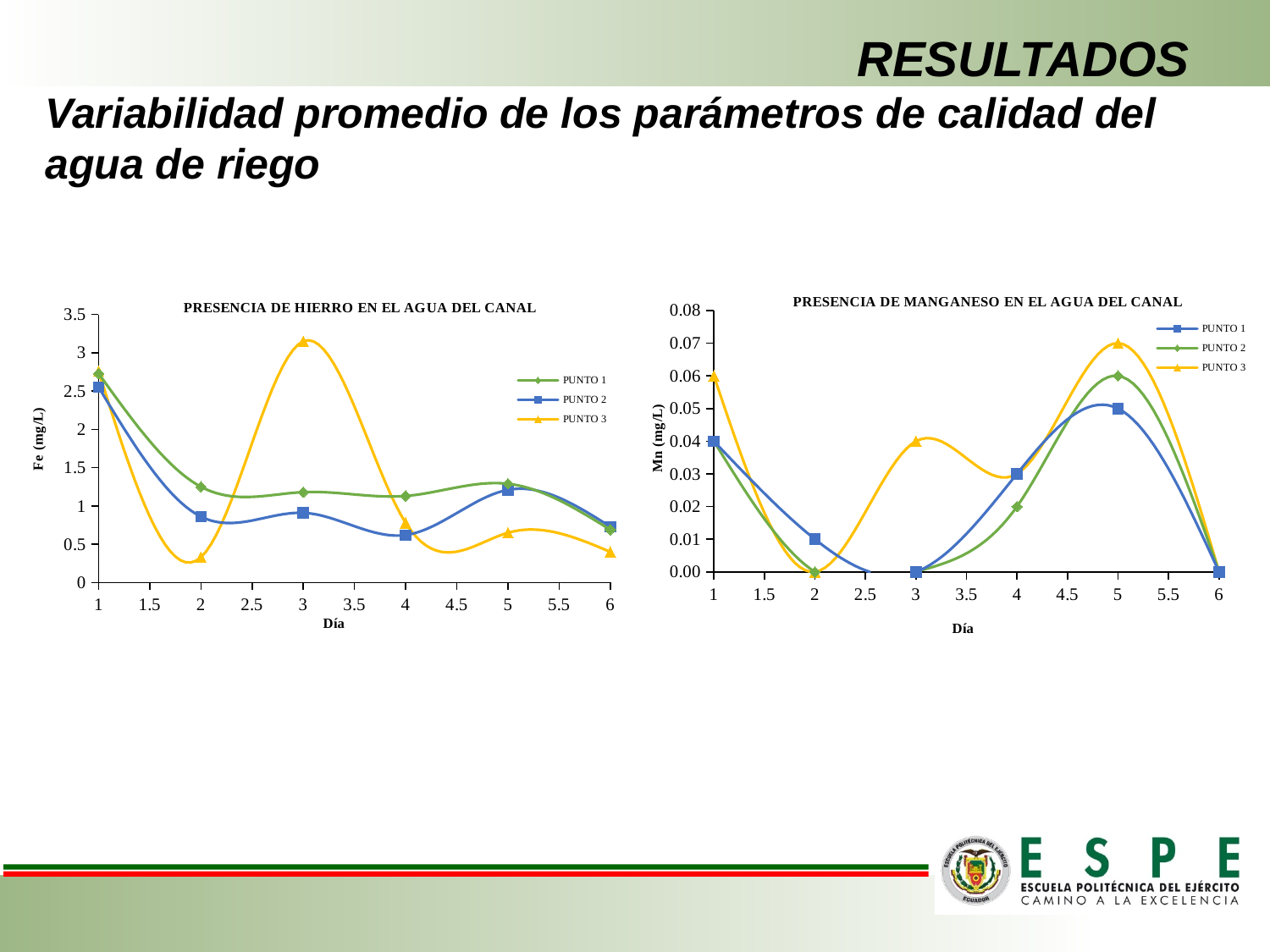
In the 'PRESENCIA DE HIERRO EN EL AGUA DEL CANAL' chart, is the value for PUNTO 2 on day 4 greater or less than 1? less In the 'PRESENCIA DE HIERRO EN EL AGUA DEL CANAL' chart, which series has the lowest value on day 2? PUNTO 3 In the 'PRESENCIA DE MANGANESO EN EL AGUA DEL CANAL' chart, is the value for PUNTO 2 on day 5 larger or smaller than the value for PUNTO 1 on day 5? larger In the 'PRESENCIA DE HIERRO EN EL AGUA DEL CANAL' chart, is the value for PUNTO 3 on day 3 greater or less than 3? greater In the 'PRESENCIA DE MANGANESO EN EL AGUA DEL CANAL' chart, what is the value for PUNTO 1 on day 1? 0.04 How many series does the legend of the 'PRESENCIA DE MANGANESO EN EL AGUA DEL CANAL' chart list? 3 In the 'PRESENCIA DE HIERRO EN EL AGUA DEL CANAL' chart, what is the label of the y axis? Fe (mg/L) In the 'PRESENCIA DE HIERRO EN EL AGUA DEL CANAL' chart, which series has the highest value on day 3? PUNTO 3 What kind of chart is the 'PRESENCIA DE HIERRO EN EL AGUA DEL CANAL' chart? Line chart In the 'PRESENCIA DE MANGANESO EN EL AGUA DEL CANAL' chart, what is the value for PUNTO 3 on day 5? 0.07 In the 'PRESENCIA DE MANGANESO EN EL AGUA DEL CANAL' chart, which series has the highest value on day 5? PUNTO 3 In the 'PRESENCIA DE MANGANESO EN EL AGUA DEL CANAL' chart, how many days are plotted on the x axis for each series? 6